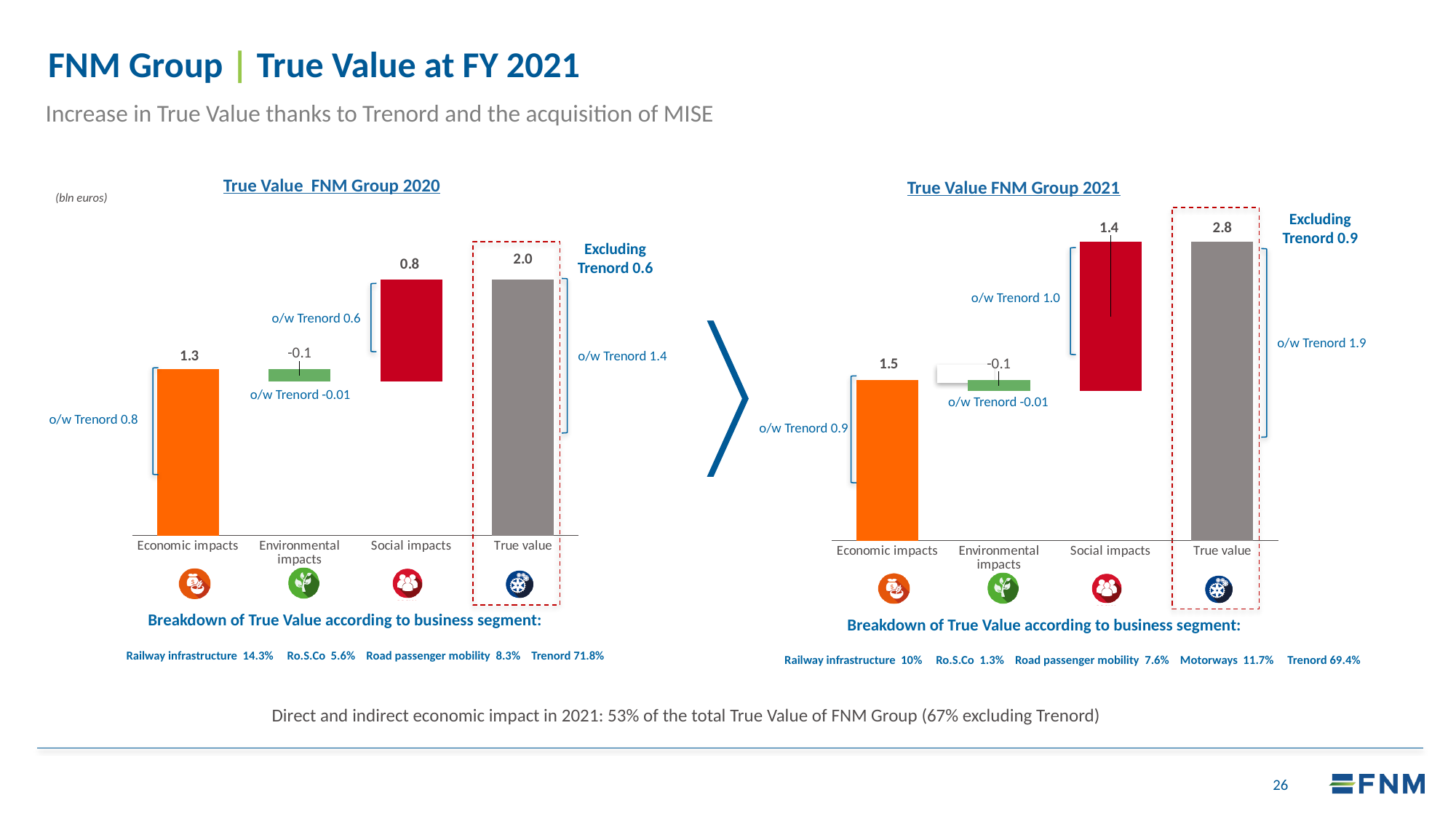
In the True Value FNM Group 2020 chart, which category has the highest value? True value What is the difference between the True value in the 2021 chart and the True value in the 2020 chart? 0.8 What kind of chart is the True Value FNM Group 2020 chart? Bar chart In the True Value FNM Group 2021 chart, what colour is the Social impacts bar? Red In the True Value FNM Group 2021 chart, what is the value for True value? 2.8 In the True Value FNM Group 2021 chart, which category has the lowest value? Environmental impacts In the True Value FNM Group 2020 chart, what is the value for Social impacts? 0.8 In the True Value FNM Group 2020 chart, what is the value for Economic impacts? 1.3 In the True Value FNM Group 2021 chart, what is the value for Environmental impacts? -0.1 How many categories are shown on the x axis of the True Value FNM Group 2021 chart? 4 In the True Value FNM Group 2021 chart, what is the difference between Economic impacts and Social impacts? 0.1 In the True Value FNM Group 2020 chart, which is larger: Economic impacts or Social impacts? Economic impacts